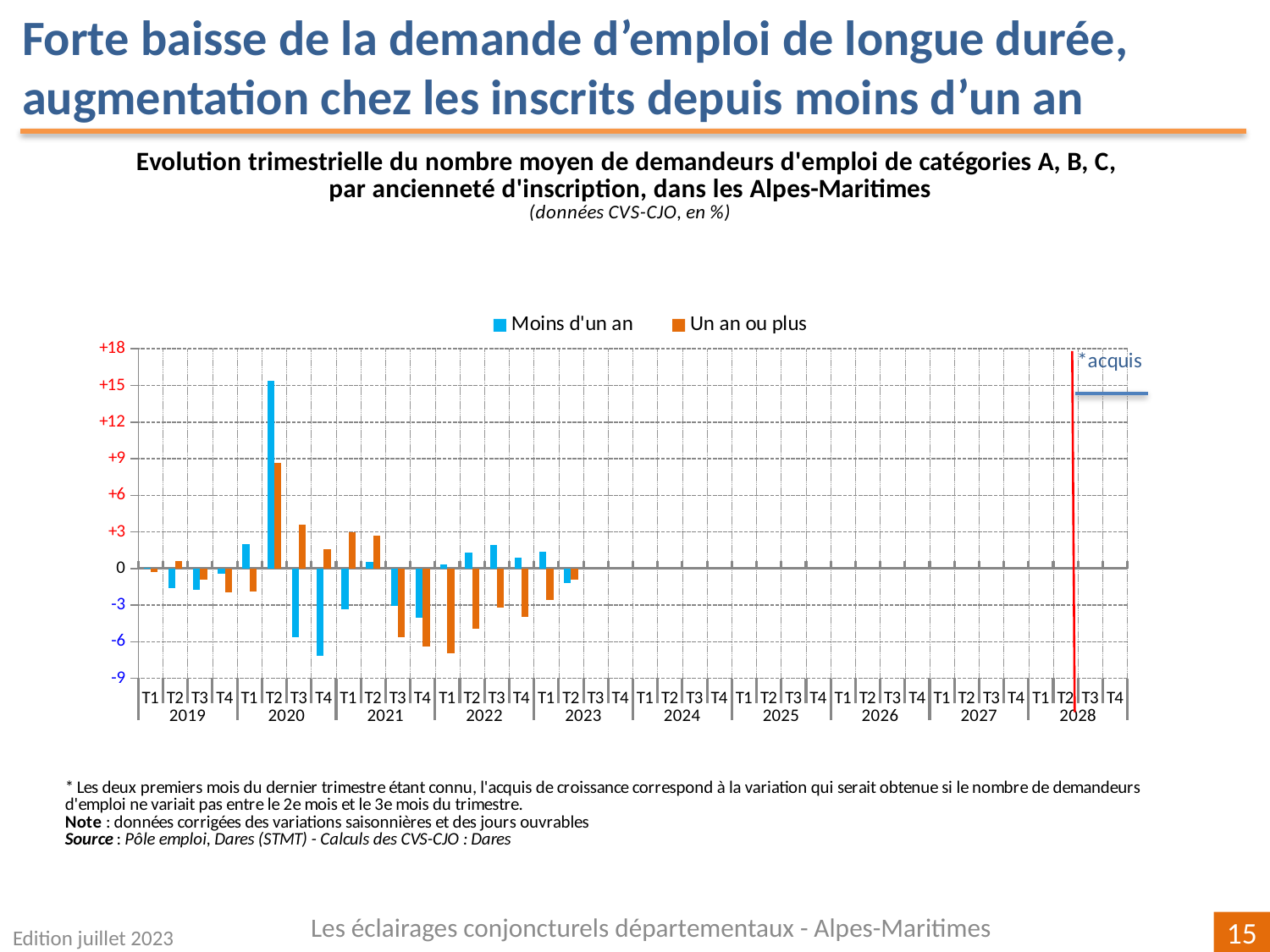
How many years are labelled along the x axis? 10 Is the value for 'Un an ou plus' in T1 2022 greater or less than -6? less How many series does the legend list? 2 Is the value for 'Un an ou plus' in T2 2020 greater or less than +6? greater What are the two series named in the legend? Moins d'un an; Un an ou plus In which quarter does the 'Moins d'un an' series reach its highest value? T2 2020 Is the value for 'Un an ou plus' in T3 2021 greater or less than -3? less What kind of chart is shown on the slide? bar chart In T2 2020, which series has the larger value, 'Moins d'un an' or 'Un an ou plus'? Moins d'un an What label is attached to the red vertical line near the right of the chart? acquis